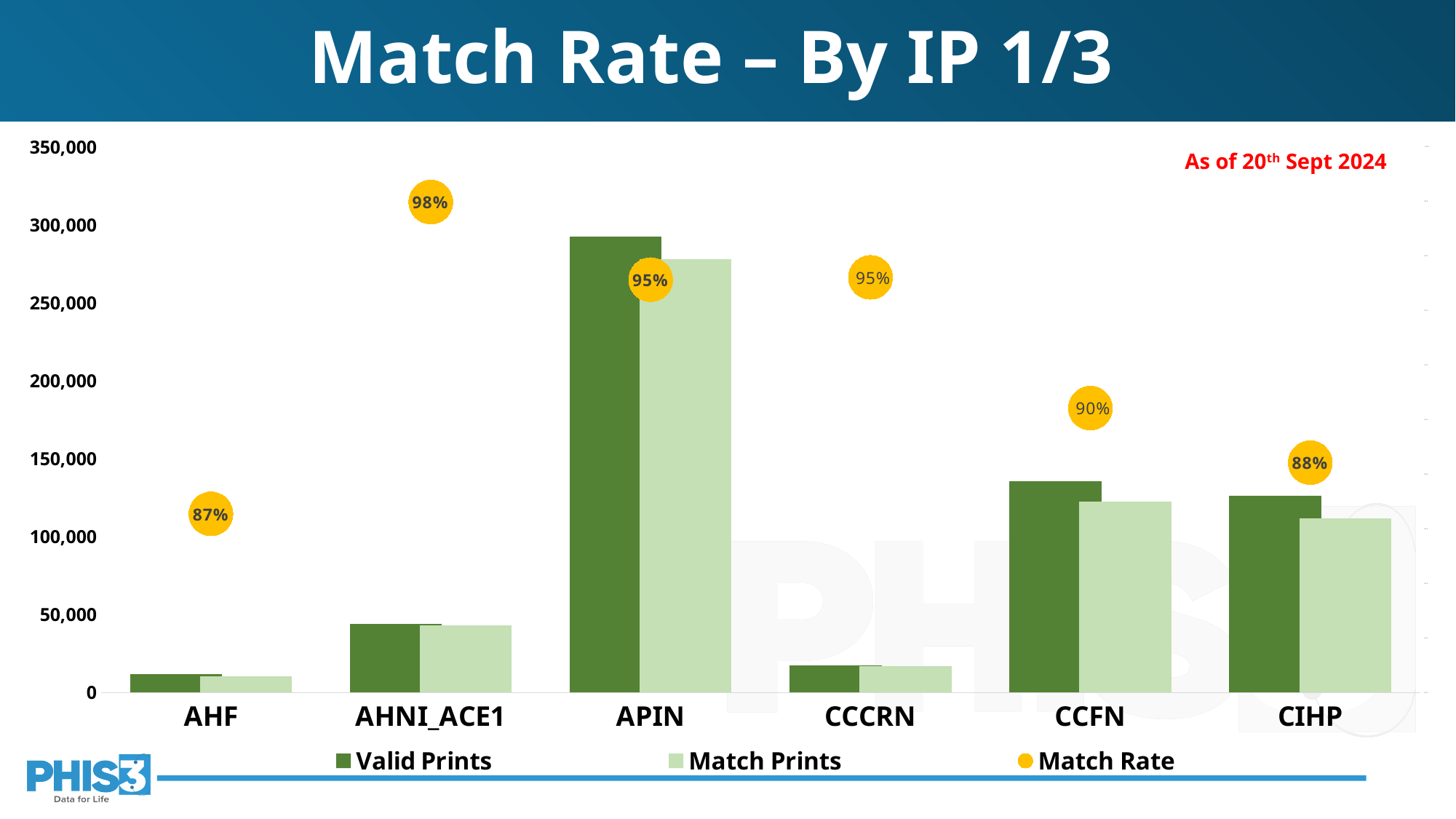
Which IP has the lowest Match Rate? AHF How many series does the chart legend list? 3 Is the value of Valid Prints for APIN greater or less than 250,000? greater Which IP has the highest Match Rate? AHNI_ACE1 Is the value of Valid Prints for CCCRN greater or less than 50,000? less What is the Match Rate for CIHP? 88% What is the Match Rate for CCFN? 90% What is the Match Rate for AHNI_ACE1? 98% What is the Match Rate for AHF? 87% What is the difference between the Match Rate of AHNI_ACE1 and the Match Rate of AHF? 11% Which IP has more Valid Prints, APIN or CCFN? APIN How many IPs are shown on the x axis of the chart? 6